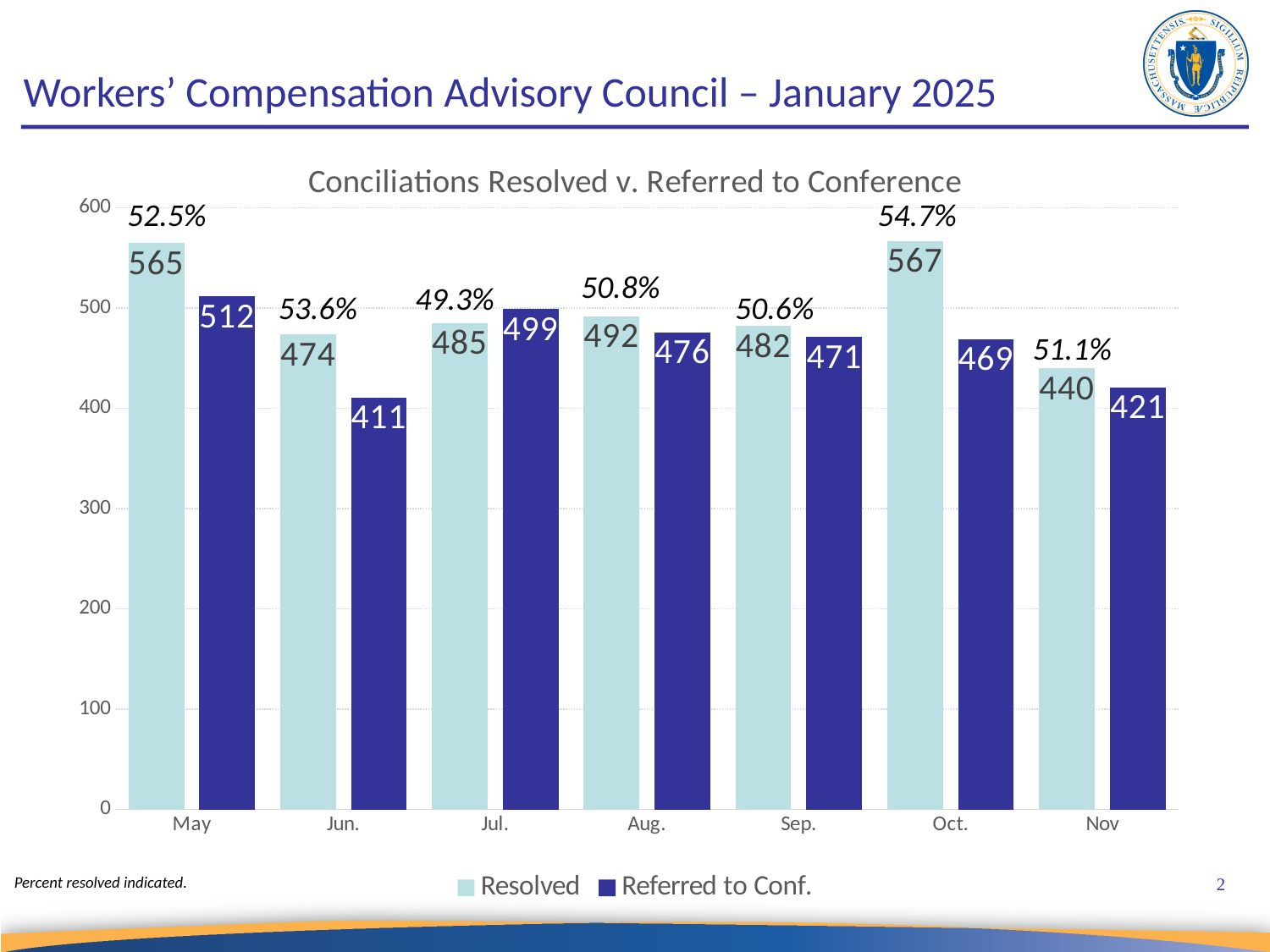
What is the difference between the Resolved and Referred to Conf. values for Jun.? 63 How many months are shown on the x axis? 7 Is the Referred to Conf. value for Nov greater or less than 500? less What is the Referred to Conf. value for Jun.? 411 What kind of chart is shown? bar chart What percent resolved is indicated for Oct.? 54.7% What is the Resolved value for May? 565 Which month has the lowest Referred to Conf. value? Jun. Which month has the highest Resolved value? Oct. Which is larger for Jul., the Resolved value or the Referred to Conf. value? Referred to Conf. How many series does the legend list? 2 What is the title of the chart? Conciliations Resolved v. Referred to Conference